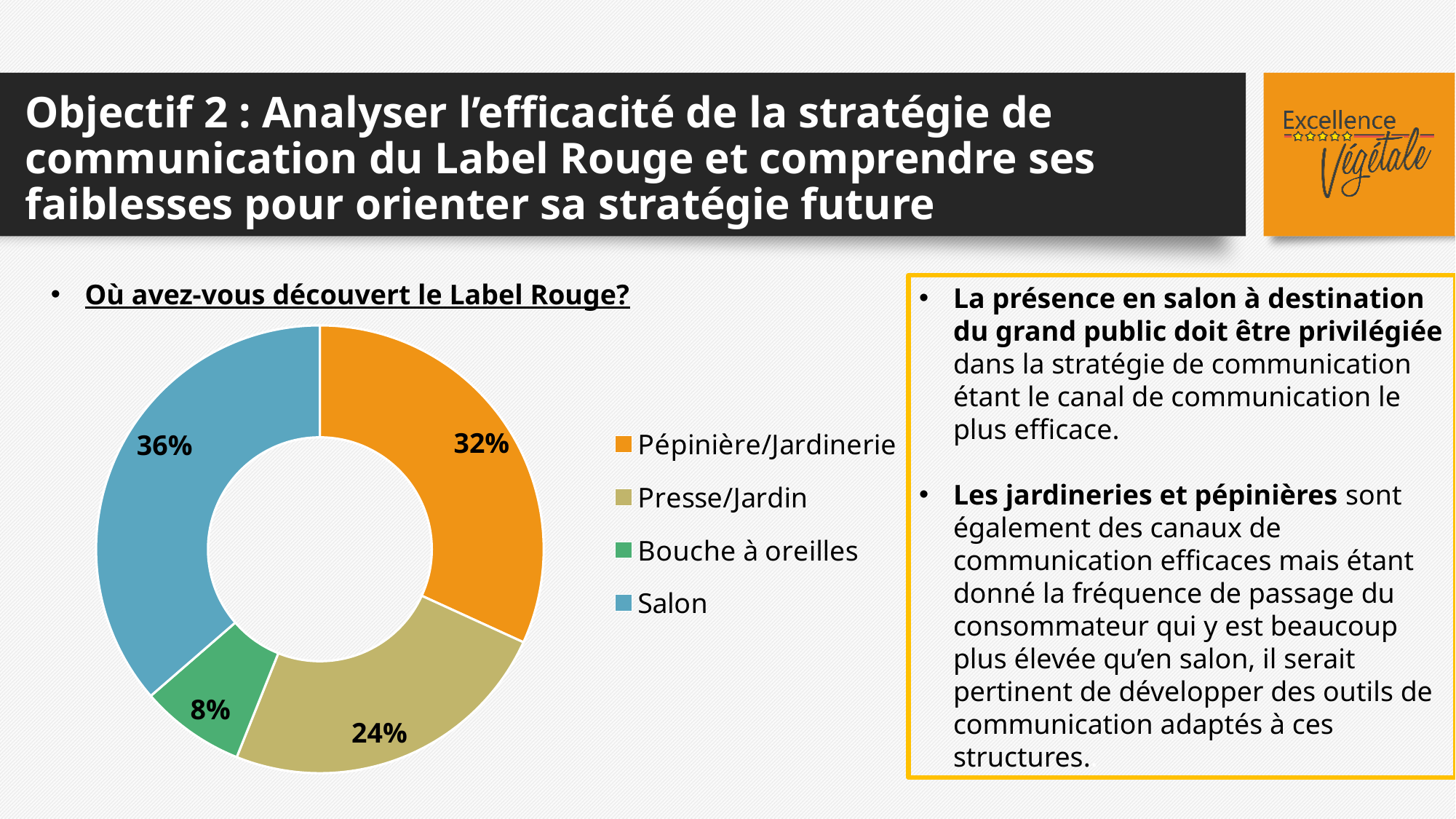
What kind of chart is shown on the slide? Pie chart (doughnut) What is the difference between the shares of Salon and Pépinière/Jardinerie? 4% How many categories does the chart show? 4 What is the value for Bouche à oreilles? 8% Which category has the largest share? Salon What is the value for Presse/Jardin? 24% What is the value for Pépinière/Jardinerie? 32% What is the difference between the shares of Presse/Jardin and Bouche à oreilles? 16% What share of the pie does Salon represent? 36% Which category has the smallest share? Bouche à oreilles Which colour represents Salon in the chart? Blue Which is larger, Presse/Jardin or Bouche à oreilles? Presse/Jardin